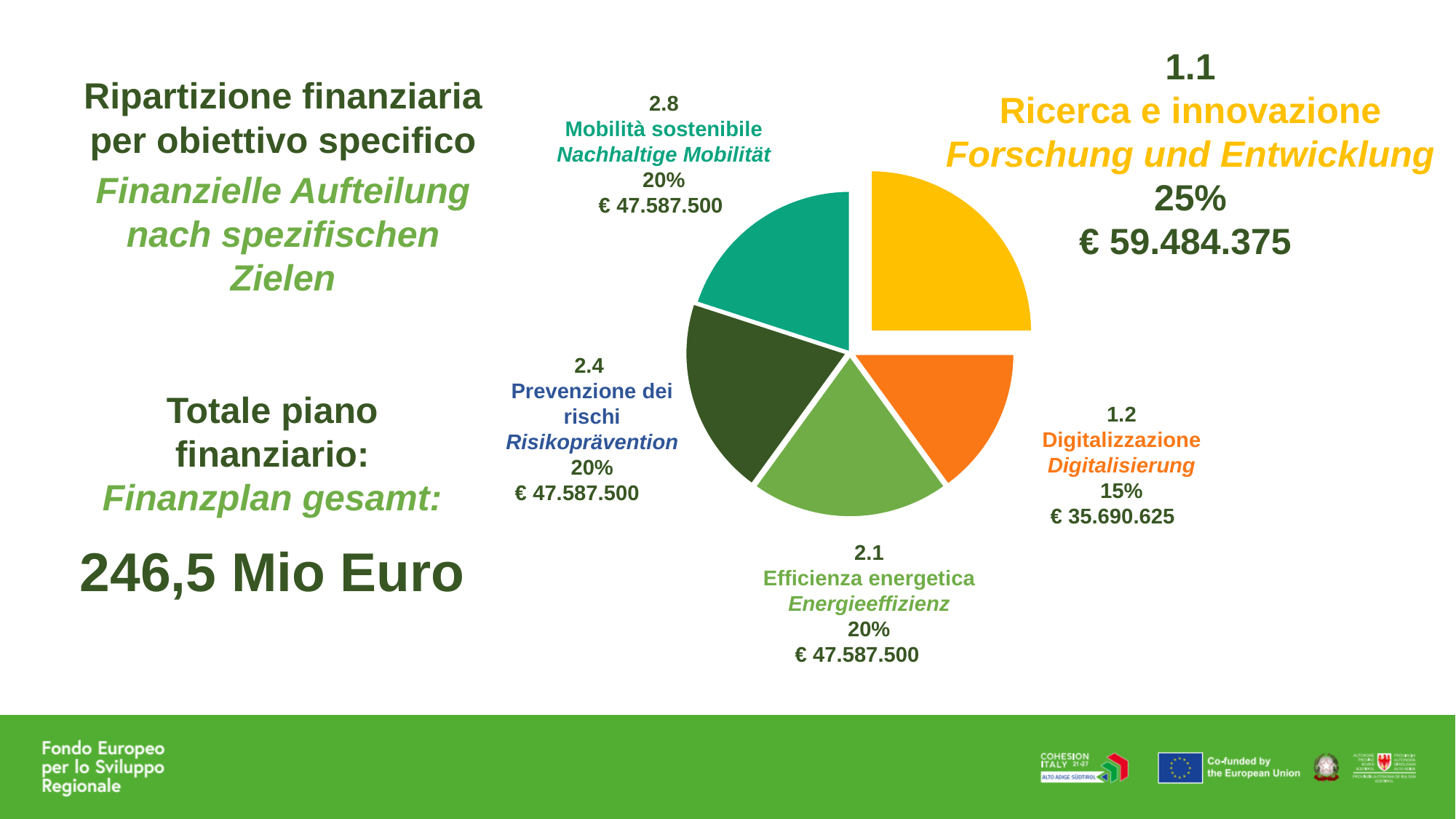
Which objective has the smallest slice of the pie? 1.2 Digitalizzazione How many slices does the pie chart have? 5 What percentage is shown for 2.1 Efficienza energetica? 20% Which objective has the largest slice of the pie? 1.1 Ricerca e innovazione What kind of chart is shown on the slide? pie chart Which is larger, the share for 2.4 Prevenzione dei rischi or the share for 1.2 Digitalizzazione? 2.4 Prevenzione dei rischi What share of the pie does 1.1 Ricerca e innovazione represent? 25% What is the total financial plan stated on the slide? 246,5 Mio Euro What colour is the slice for 1.2 Digitalizzazione? orange What is the amount shown for 1.2 Digitalizzazione? € 35.690.625 What is the amount shown for 2.8 Mobilità sostenibile? € 47.587.500 What is the difference in amount between 1.1 Ricerca e innovazione and 1.2 Digitalizzazione? € 23.793.750